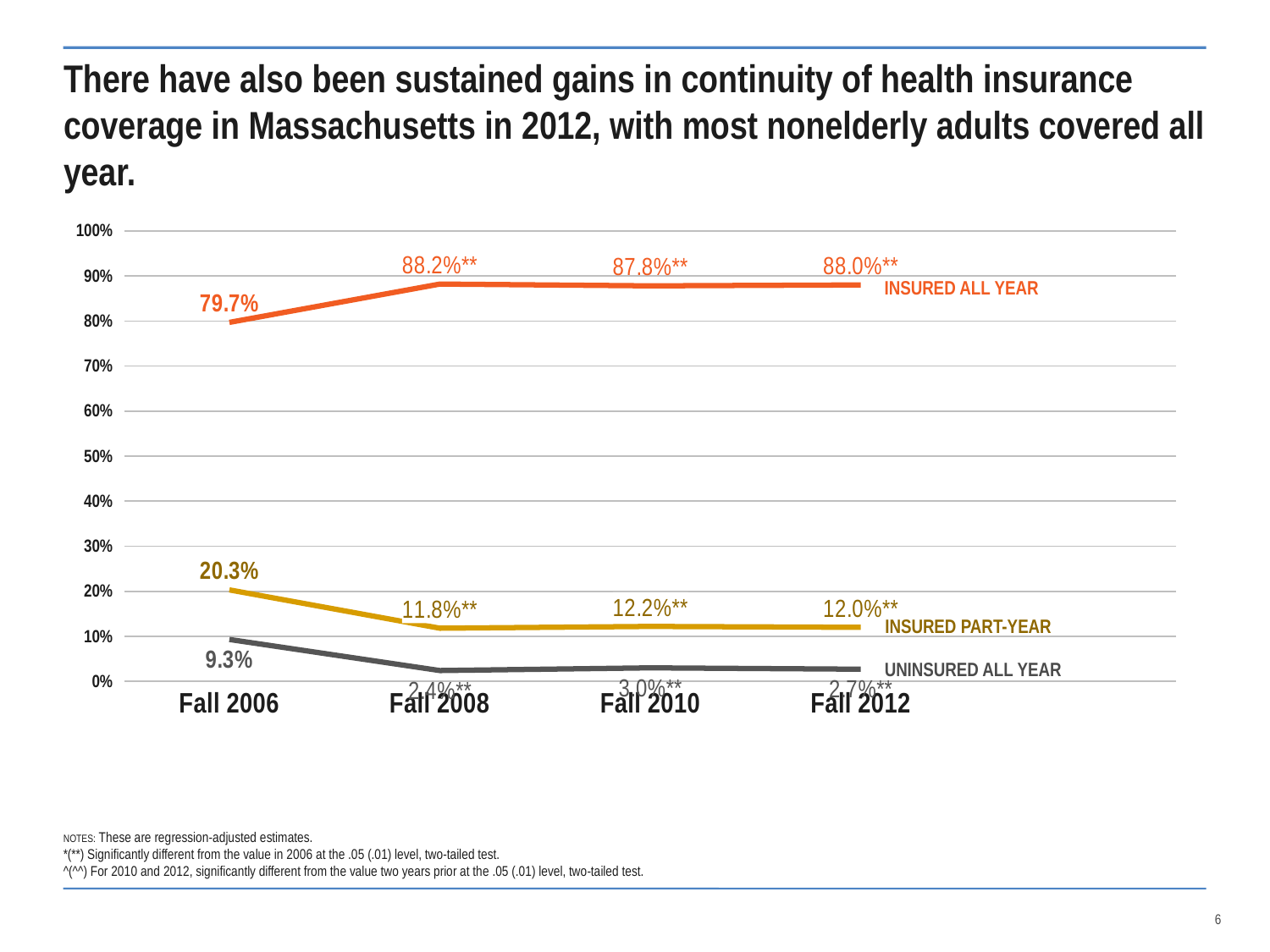
What kind of chart is shown on the slide? Line chart What is the value for Uninsured All Year in Fall 2006? 9.3% In which period is the Insured Part-Year value lowest? Fall 2008 Which is larger for Insured All Year: the Fall 2010 value or the Fall 2012 value? Fall 2012 What is the difference between the Insured Part-Year values in Fall 2006 and Fall 2012? 8.3 percentage points What is the value for Insured All Year in Fall 2006? 79.7% How many time periods are plotted on the x axis? 4 In which period is the Insured All Year value highest? Fall 2008 By how much did the Insured All Year value increase from Fall 2006 to Fall 2008? 8.5 percentage points How many series are plotted on the chart? 3 What is the value for Insured All Year in Fall 2012? 88.0% What is the value for Insured Part-Year in Fall 2008? 11.8%